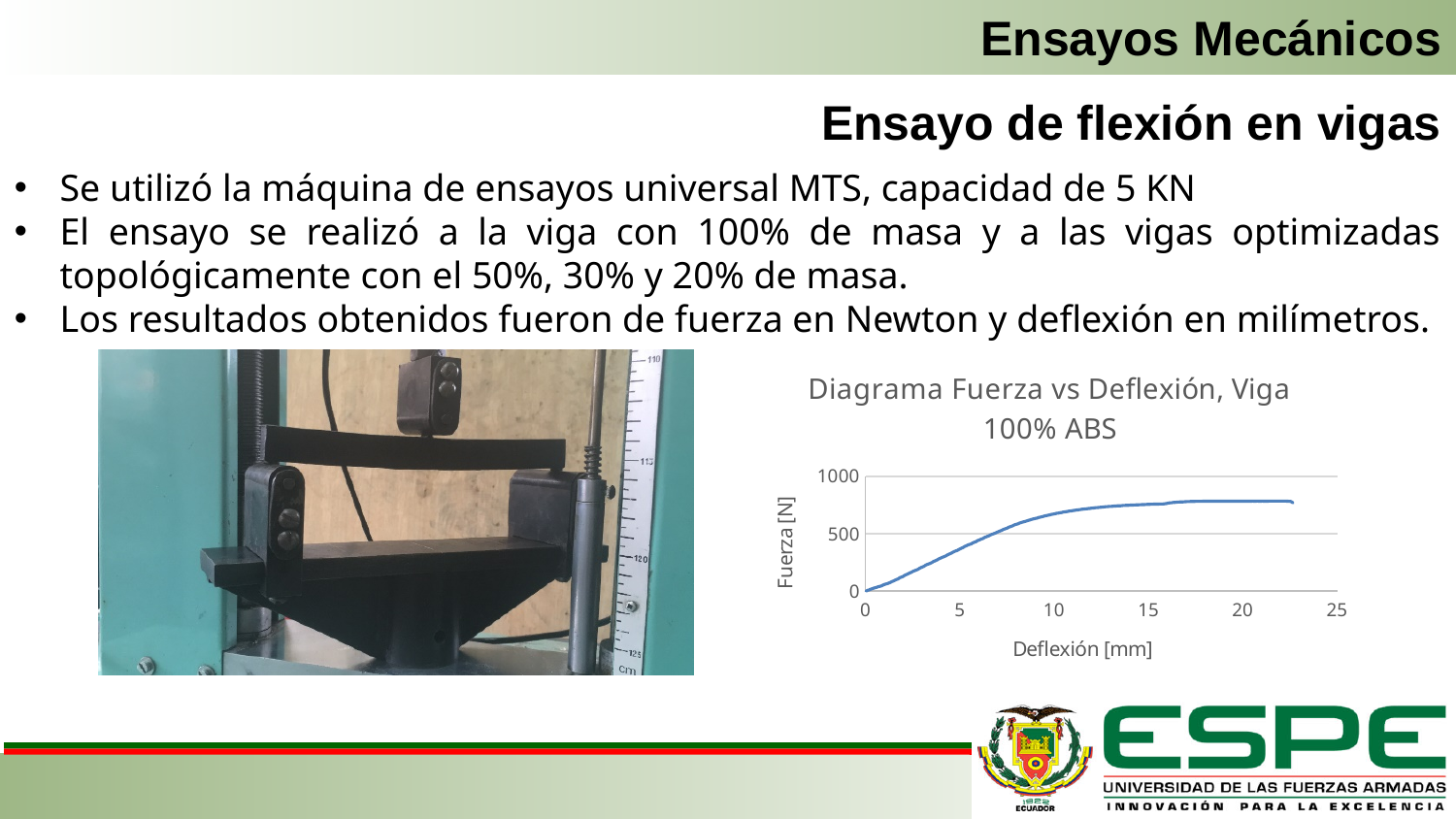
Which is larger, the force at 5 mm deflection or the force at 15 mm deflection? 15 mm Is the force at a deflection of 20 mm greater or less than 500 N? greater What is the title of the chart? Diagrama Fuerza vs Deflexión, Viga 100% ABS Is the force at a deflection of 15 mm greater or less than 1000 N? less What is the highest value shown on the vertical axis of the chart? 1000 What kind of chart is shown on the slide? line chart Is the force at a deflection of 5 mm greater or less than 500 N? less Does the force rise or fall as deflection increases along the x axis? rise What is the label of the vertical axis of the chart? Fuerza [N]